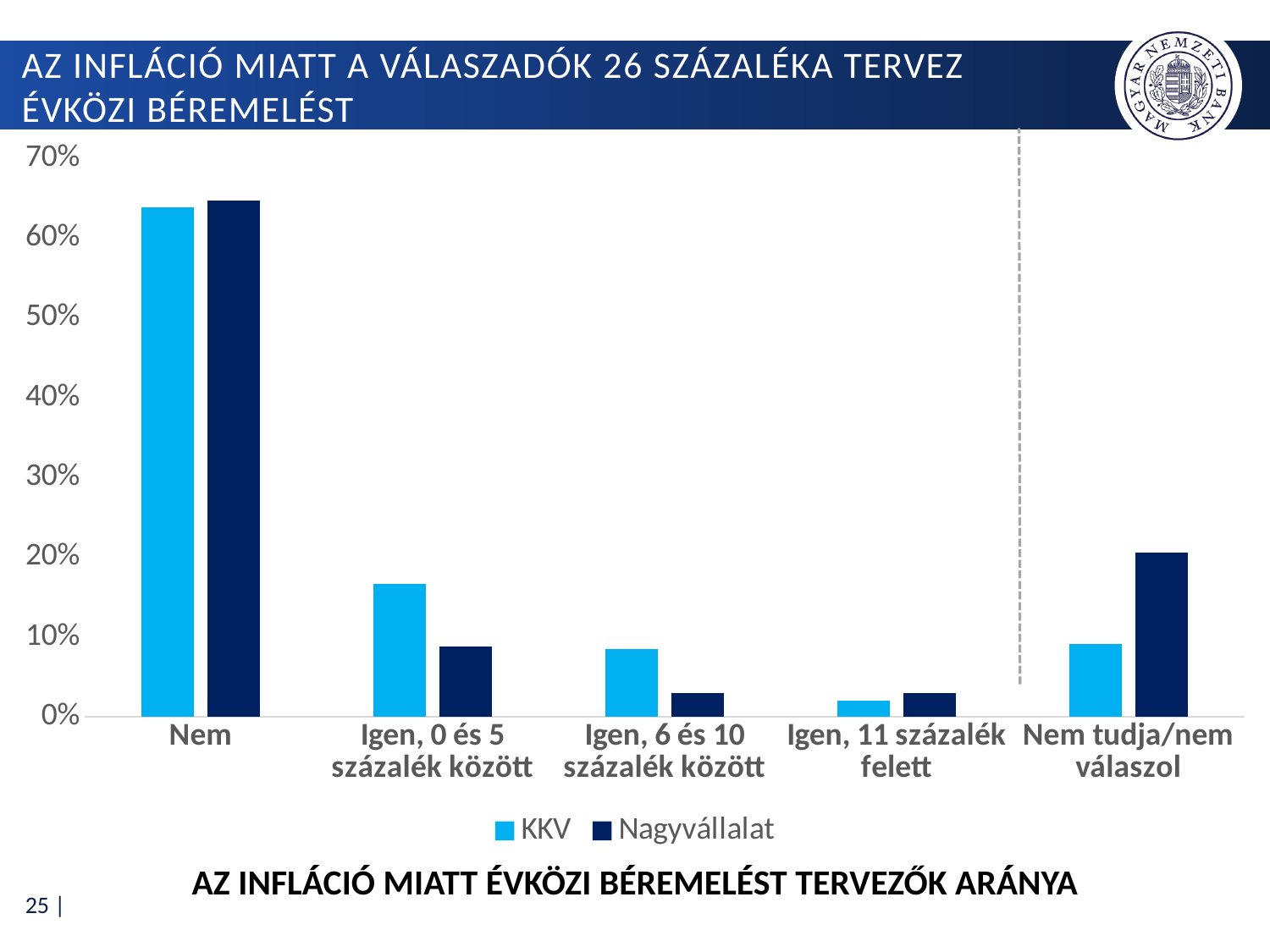
Is the Nagyvállalat value for 'Igen, 0 és 5 százalék között' greater or less than 10%? less Which category has the lowest value for the KKV series? Igen, 11 százalék felett Which category has the highest value for the KKV series? Nem What is the title shown below the chart? AZ INFLÁCIÓ MIATT ÉVKÖZI BÉREMELÉST TERVEZŐK ARÁNYA What kind of chart is shown on the slide? bar chart How many series does the legend list? 2 Which category has the highest value for the Nagyvállalat series? Nem How many categories are shown on the x axis of the chart? 5 Which series are listed in the legend? KKV and Nagyvállalat Is the KKV value for 'Nem' greater or less than 60%? greater For the category 'Igen, 0 és 5 százalék között', which series has the larger value, KKV or Nagyvállalat? KKV For the category 'Nem tudja/nem válaszol', which series has the larger value, KKV or Nagyvállalat? Nagyvállalat